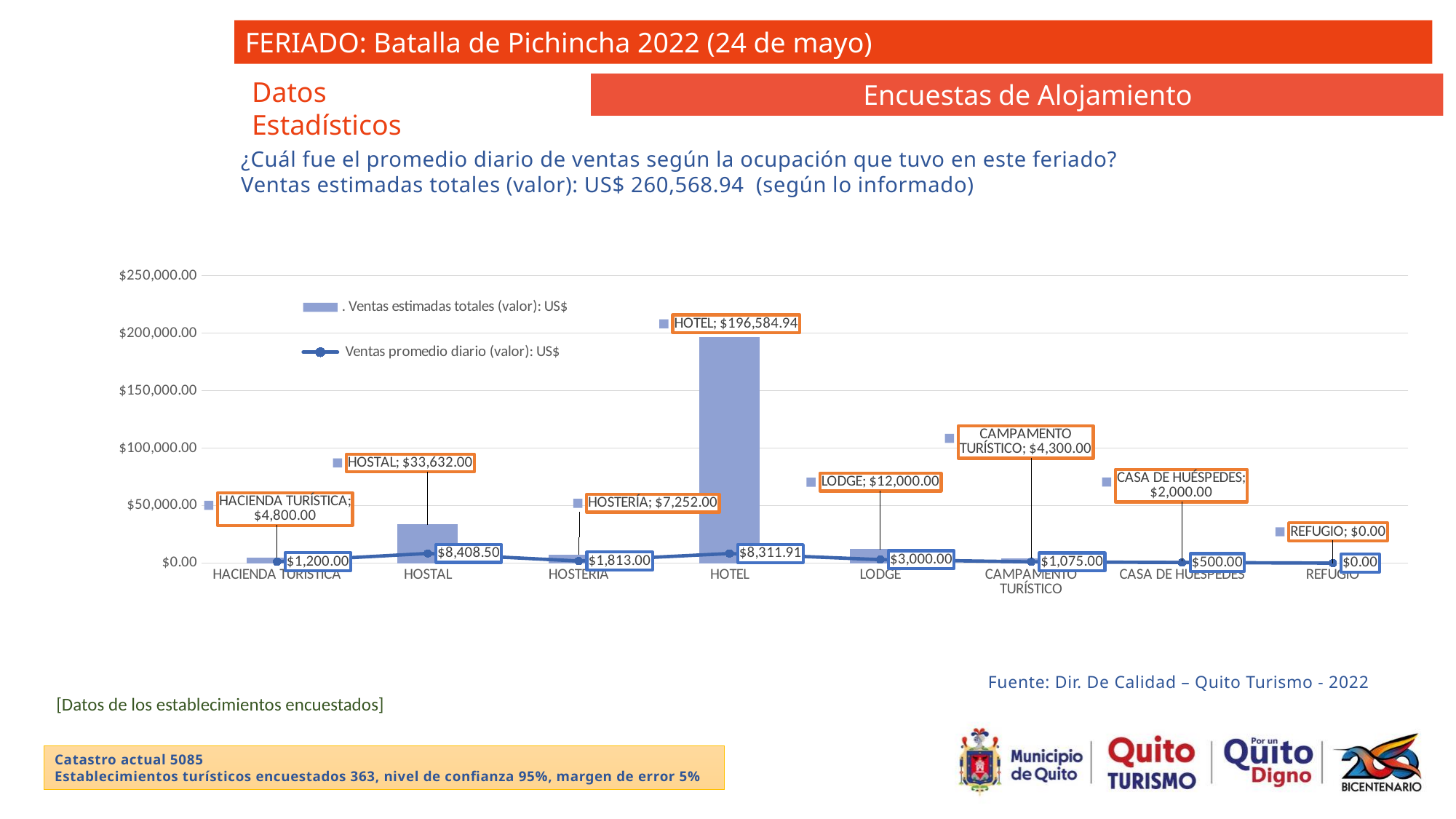
How many series does the chart legend list? 2 What kind of chart is shown on the slide? Combined bar and line chart What is the value of 'Ventas estimadas totales (valor): US$' for HOTEL? $196,584.94 How many categories are shown on the x axis of the chart? 8 What is the value of 'Ventas promedio diario (valor): US$' for CAMPAMENTO TURÍSTICO? $1,075.00 Which category has the lowest 'Ventas promedio diario (valor): US$'? REFUGIO What is the difference between the 'Ventas promedio diario' for LODGE and for CASA DE HUÉSPEDES? $2,500.00 What is the difference between the 'Ventas estimadas totales' for HOSTAL and for HOSTERÍA? $26,380.00 Which category has the highest 'Ventas estimadas totales (valor): US$'? HOTEL What is the value of 'Ventas estimadas totales (valor): US$' for LODGE? $12,000.00 Which is larger: the 'Ventas promedio diario' for HOSTAL or for HOTEL? HOSTAL What is the value of 'Ventas promedio diario (valor): US$' for HOSTAL? $8,408.50